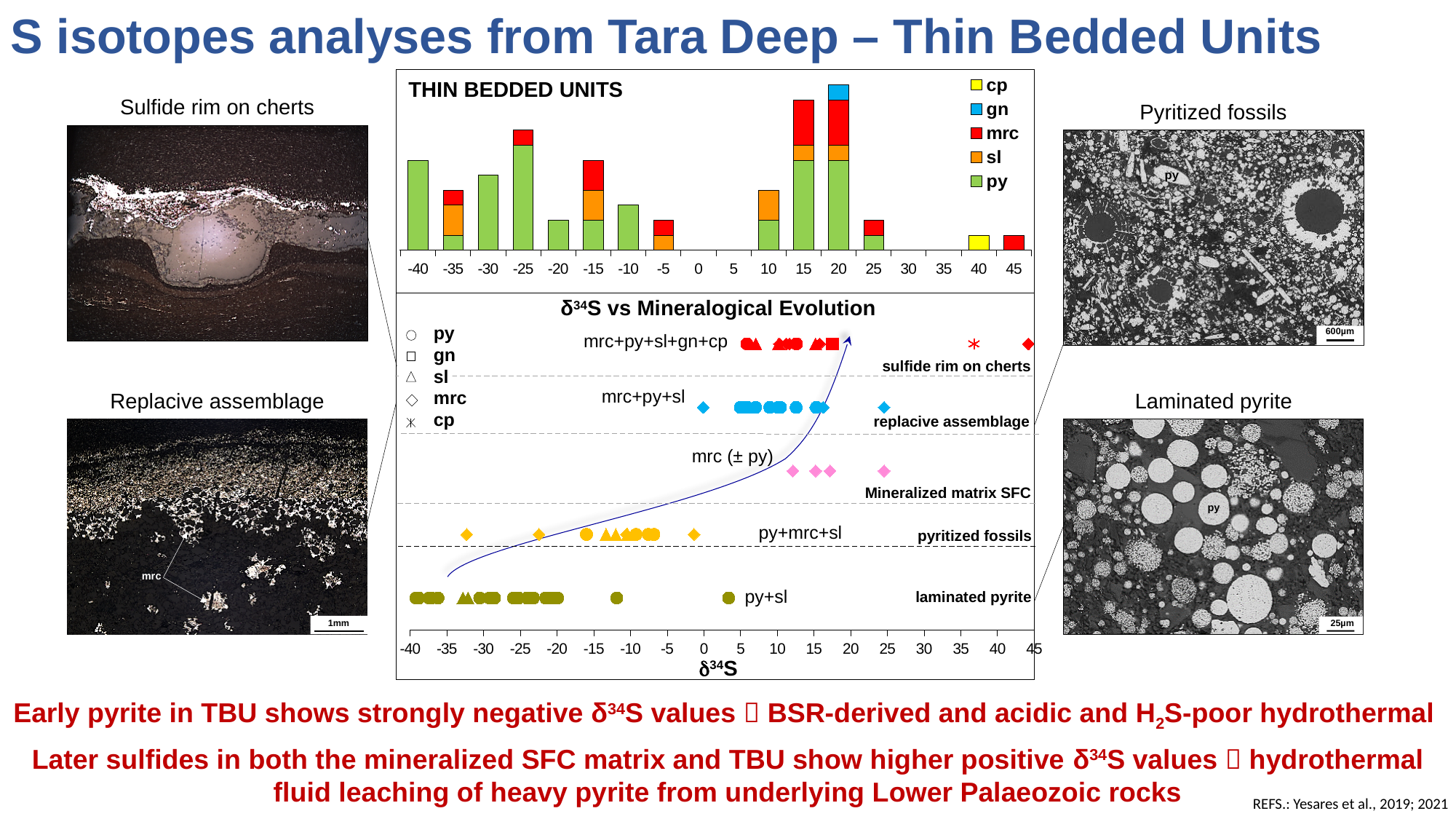
In the bottom chart 'δ34S vs Mineralogical Evolution', do δ34S values increase or decrease going from laminated pyrite up to sulfide rim on cherts? increase In the top chart 'THIN BEDDED UNITS', how many δ34S bins have a bar plotted? 14 What is the x-axis label of the bottom chart 'δ34S vs Mineralogical Evolution'? δ34S In the top chart 'THIN BEDDED UNITS', how many series does the legend list? 5 What kind of chart is the top chart titled 'THIN BEDDED UNITS'? bar chart In the top chart 'THIN BEDDED UNITS', how many tick labels are shown on the x axis? 18 In the bottom chart 'δ34S vs Mineralogical Evolution', how many mineral symbols are listed in the legend? 5 In the bottom chart 'δ34S vs Mineralogical Evolution', which assemblage has the most negative δ34S values? laminated pyrite In the top chart 'THIN BEDDED UNITS', which bar is taller, the one at -40 or the one at -20? -40 In the top chart 'THIN BEDDED UNITS', which δ34S bin has the tallest stacked bar? 20 In the top chart 'THIN BEDDED UNITS', which δ34S bin is the only one with a cp (yellow) segment? 40 In the top chart 'THIN BEDDED UNITS', which δ34S bin contains the gn (blue) segment? 20